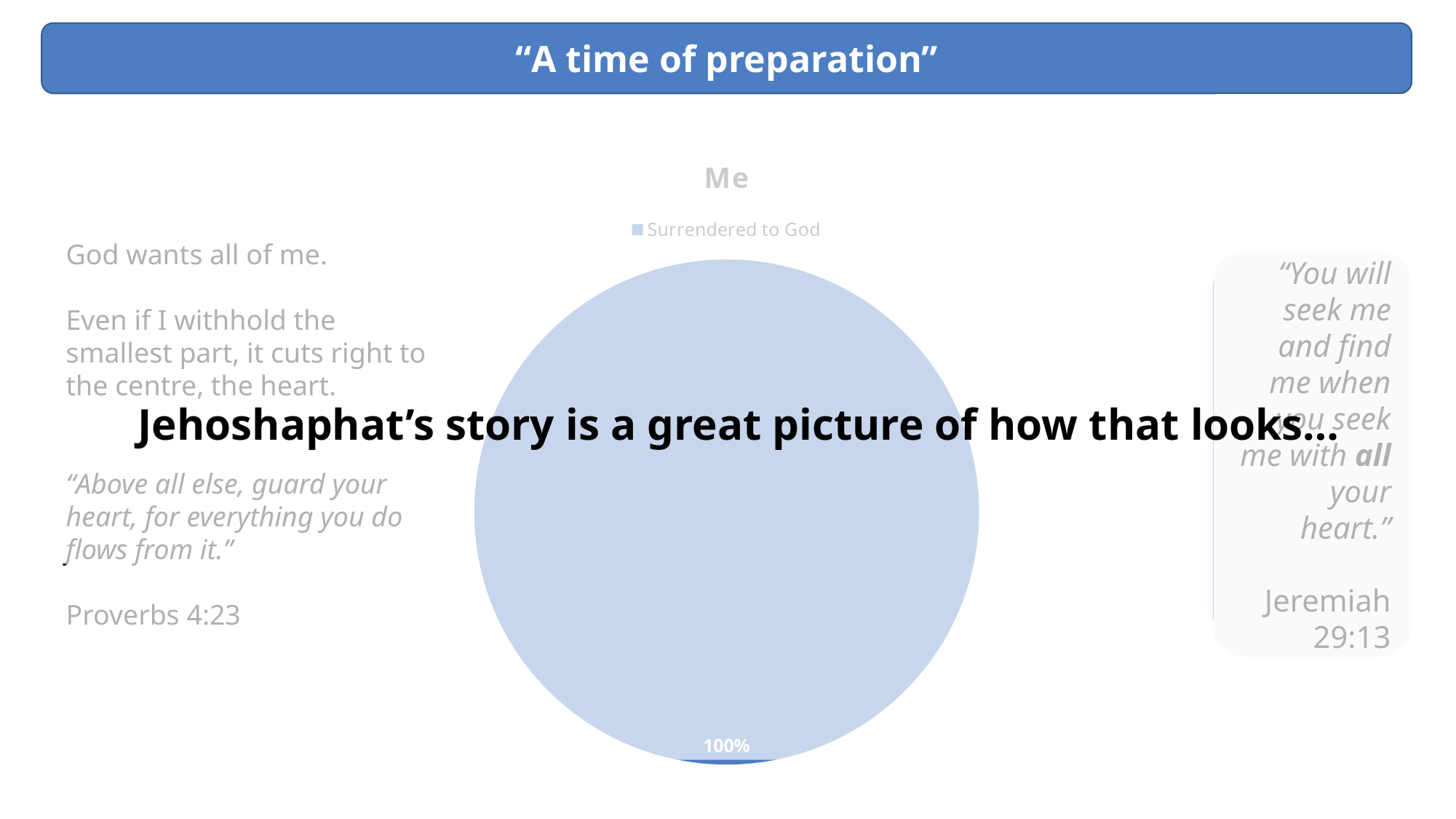
What percentage is printed on the 'Surrendered to God' slice of the pie chart? 100% What kind of chart is shown on the slide? pie chart Is the value shown for 'Surrendered to God' in the pie chart greater or less than 50%? greater What is the title of the pie chart? Me What share of the pie chart does the 'Surrendered to God' slice take up? 100% What entry does the legend of the pie chart list? Surrendered to God How many entries does the legend of the pie chart list? 1